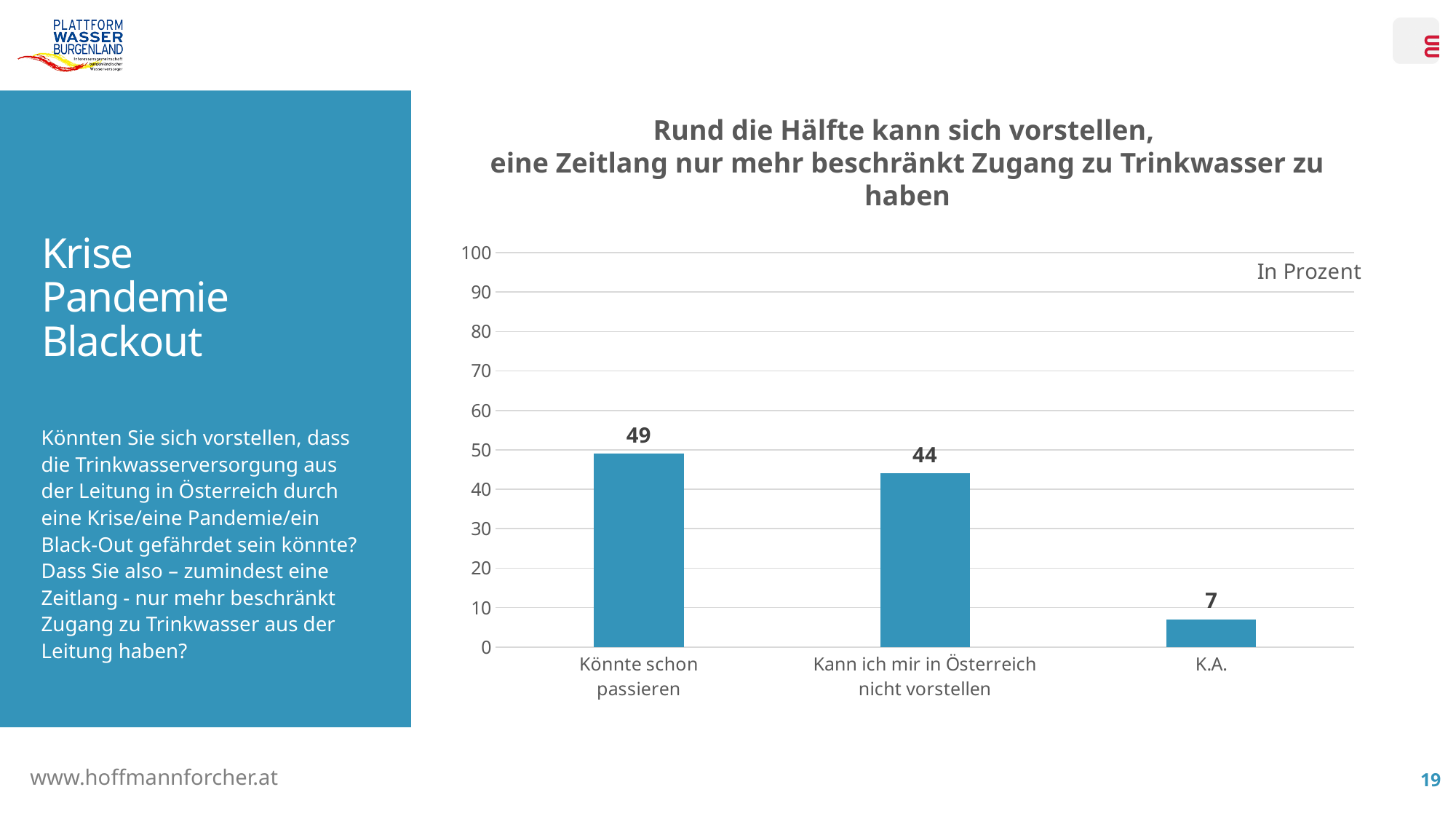
Which is larger: the value for "Könnte schon passieren" or the value for "K.A."? Könnte schon passieren What is the difference between the values for "Könnte schon passieren" and "Kann ich mir in Österreich nicht vorstellen"? 5 What is the value for "Kann ich mir in Österreich nicht vorstellen"? 44 Is the value for "Kann ich mir in Österreich nicht vorstellen" greater or less than 50? less What is the value for "K.A."? 7 What is the difference between the values for "Kann ich mir in Österreich nicht vorstellen" and "K.A."? 37 Which category has the lowest value? K.A. Which category has the highest value? Könnte schon passieren In what unit are the values shown, according to the label at the top right of the chart? In Prozent How many categories are shown in the chart? 3 What kind of chart is shown on the slide? bar chart What is the value for "Könnte schon passieren"? 49